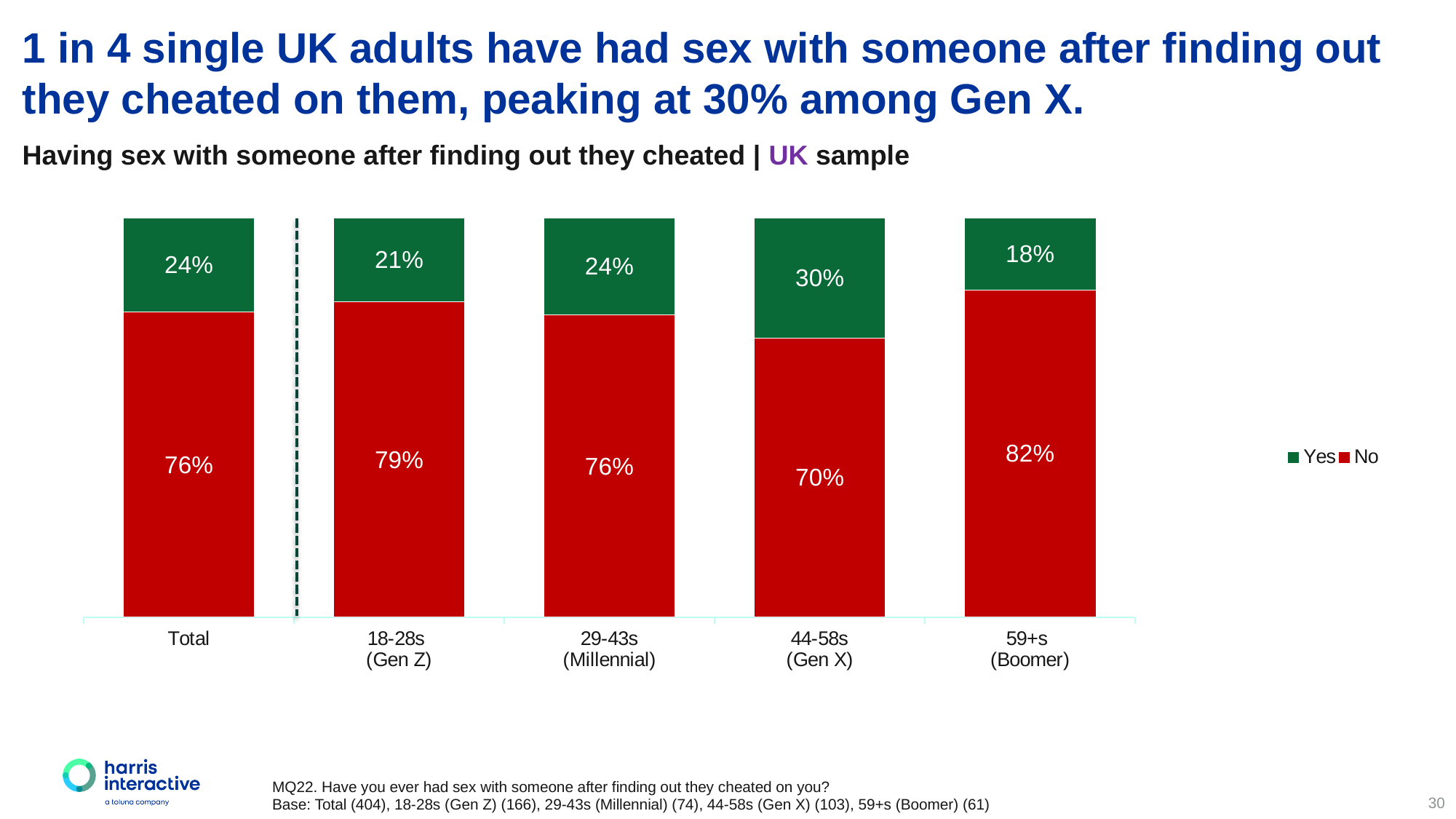
What type of chart is shown on the slide? Stacked bar chart What is the difference in Yes percentage between the 44-58s (Gen X) and the 59+s (Boomer) groups? 12 percentage points What is the Yes value for the Total bar? 24% Which age group has the highest Yes percentage? 44-58s (Gen X) How many bars (categories) are shown on the x axis? 5 Which age group has the lowest Yes percentage? 59+s (Boomer) What percentage of the 59+s (Boomer) group answered No? 82% Which is larger: the Yes value for 18-28s (Gen Z) or the Yes value for 29-43s (Millennial)? 29-43s (Millennial) What is the total of the stacked bar for the 29-43s (Millennial) group? 100% What is the No value for the 18-28s (Gen Z) group? 79% What percentage of the 44-58s (Gen X) group answered Yes? 30% How many series does the legend list? 2